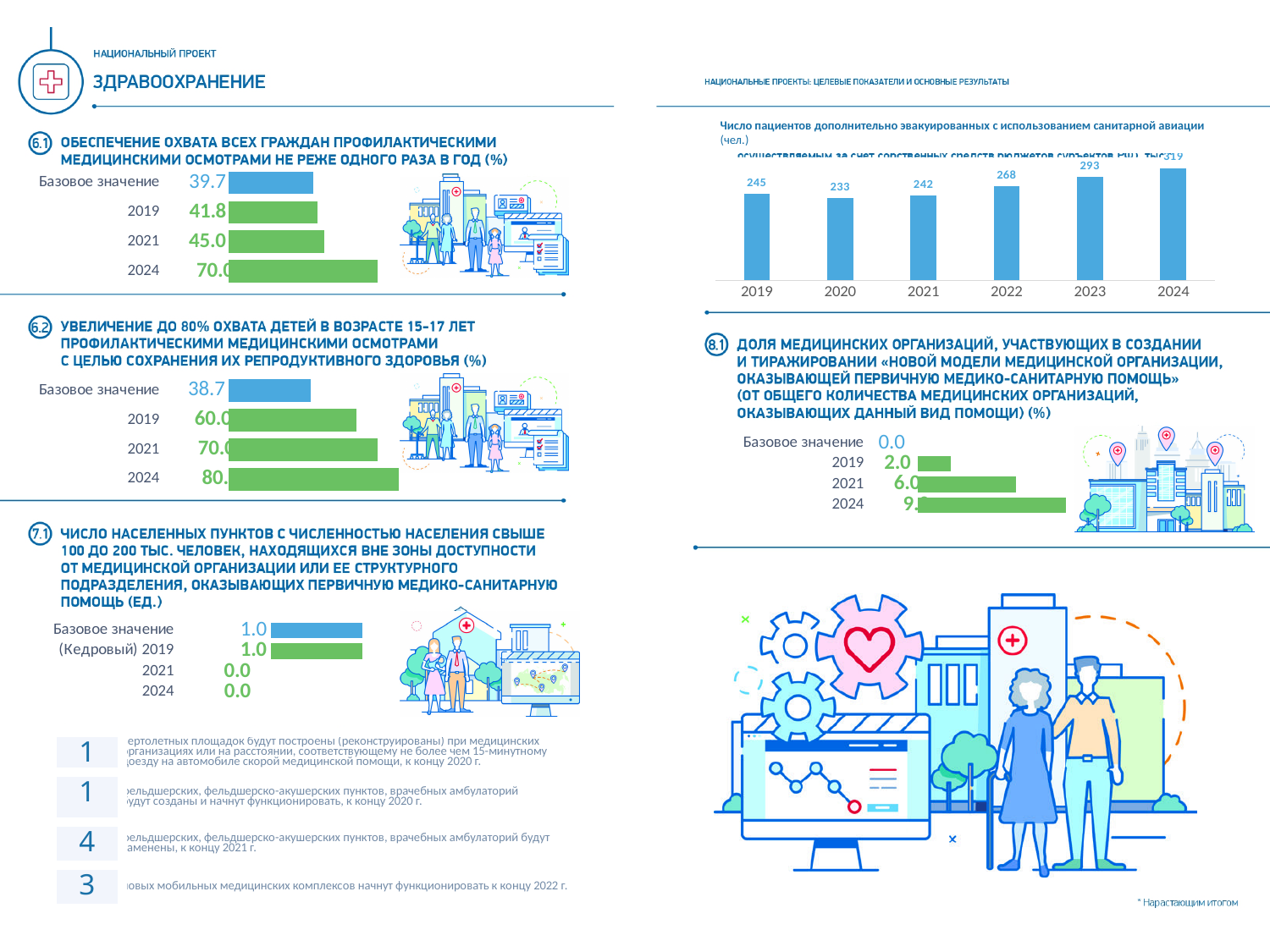
In the chart 'Число пациентов дополнительно эвакуированных с использованием санитарной авиации', what is the value for 2023? 293 In the chart 'Число пациентов дополнительно эвакуированных с использованием санитарной авиации', which year has the lowest value? 2020 In the chart for indicator 6.2 (охват детей 15-17 лет профилактическими осмотрами), what is the value for 2019? 60.0 In the chart for indicator 6.1 (охват граждан профилактическими медицинскими осмотрами), what is the value for 2024? 70.0 In the chart for indicator 8.1 (доля медицинских организаций, участвующих в создании новой модели), what is the value for 2019? 2.0 In the chart for indicator 6.1 (охват граждан профилактическими медицинскими осмотрами), what is the difference between the 2021 value and the 2019 value? 3.2 In the chart for indicator 6.1 (охват граждан профилактическими медицинскими осмотрами), what is the 'Базовое значение'? 39.7 In the chart 'Число пациентов дополнительно эвакуированных с использованием санитарной авиации', what is the difference between the values for 2024 and 2019? 74 In the chart 'Число пациентов дополнительно эвакуированных с использованием санитарной авиации', which year has the highest value? 2024 What kind of chart is 'Число пациентов дополнительно эвакуированных с использованием санитарной авиации'? bar chart How many years are shown in the chart 'Число пациентов дополнительно эвакуированных с использованием санитарной авиации'? 6 In the chart for indicator 7.1 (число населенных пунктов вне зоны доступности), what is the value for 2021? 0.0